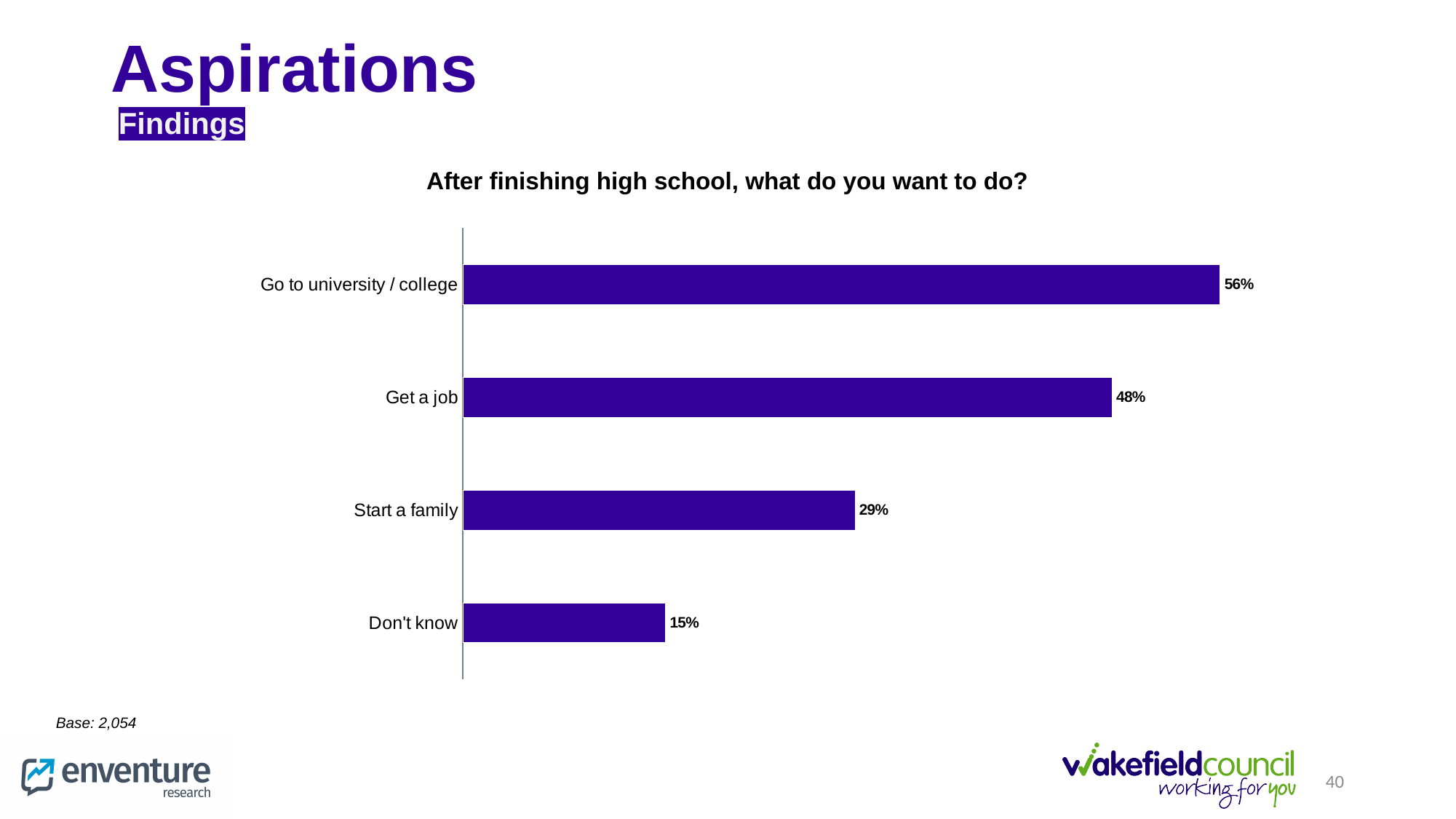
What is the value shown for 'Get a job'? 48% What is the title of the chart? After finishing high school, what do you want to do? What is the value for 'Don't know'? 15% What is the difference in percentage points between 'Start a family' and 'Don't know'? 14 Which is larger: the value for 'Get a job' or the value for 'Start a family'? Get a job Which category has the lowest value? Don't know What percentage of respondents want to go to university / college after finishing high school? 56% Which category has the highest value? Go to university / college How many categories are shown in the chart? 4 What is the difference in percentage points between 'Go to university / college' and 'Get a job'? 8 What kind of chart is shown on the slide? Bar chart What percentage of respondents said 'Start a family'? 29%